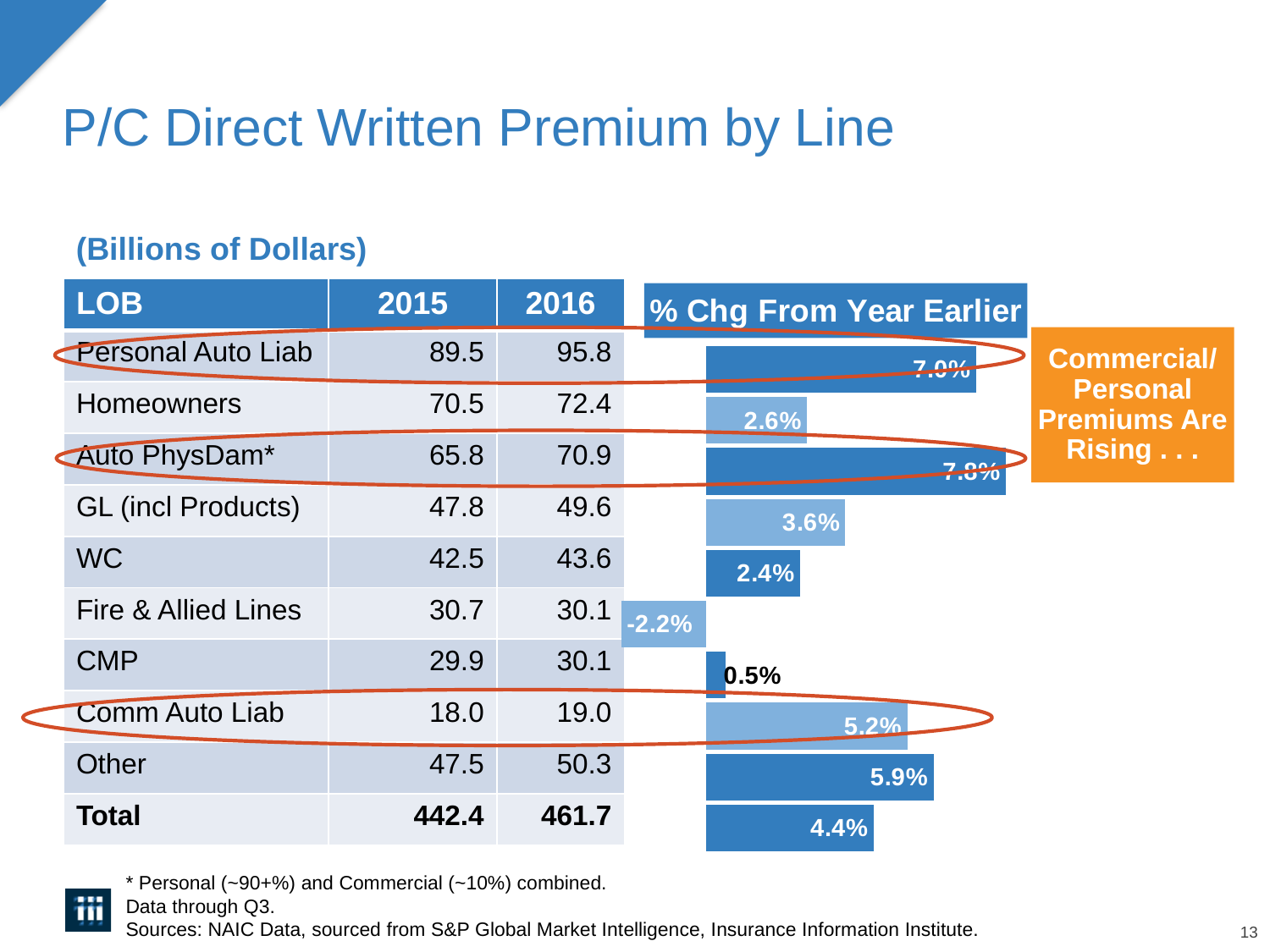
In the '% Chg From Year Earlier' chart, what is the value for Total? 4.4% In the '% Chg From Year Earlier' chart, what is the value for Homeowners? 2.6% In the '% Chg From Year Earlier' chart, which line of business has the lowest percentage change? Fire & Allied Lines In the '% Chg From Year Earlier' chart, what is the difference between the value for Other and the value for Homeowners? 3.3% In the '% Chg From Year Earlier' chart, what is the value for Comm Auto Liab? 5.2% In the '% Chg From Year Earlier' chart, what is the value for CMP? 0.5% What kind of chart is shown next to the table under '% Chg From Year Earlier'? bar chart In the '% Chg From Year Earlier' chart, what is the value for Fire & Allied Lines? -2.2% In the '% Chg From Year Earlier' chart, which is larger: the value for Other or the value for Comm Auto Liab? Other In the '% Chg From Year Earlier' chart, what is the value for WC? 2.4% How many bars are shown in the '% Chg From Year Earlier' chart? 10 In the '% Chg From Year Earlier' chart, which line of business has the highest percentage change? Auto PhysDam